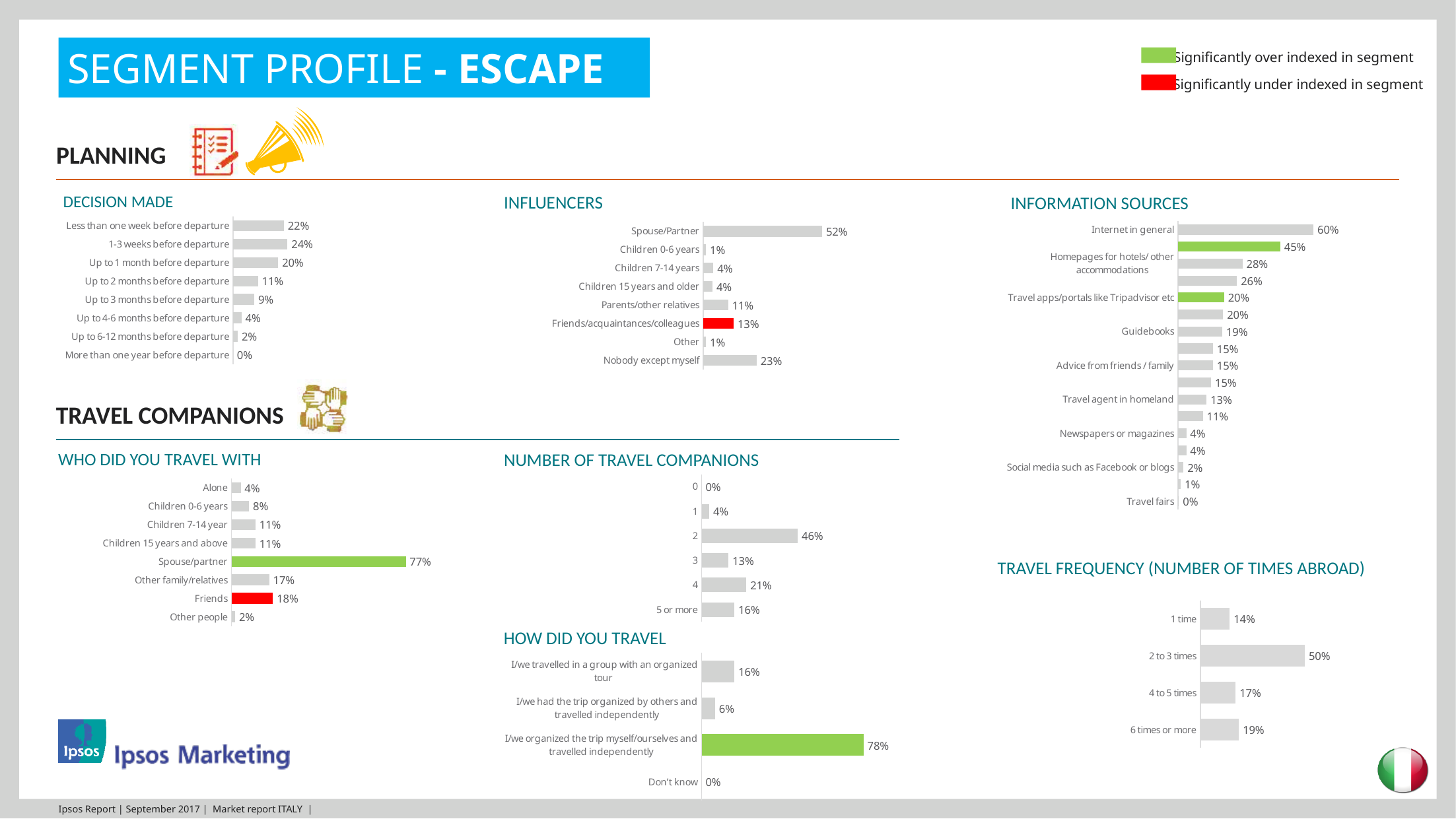
In the HOW DID YOU TRAVEL chart, what is the value for 'I/we organized the trip myself/ourselves and travelled independently'? 78% What type of chart is the TRAVEL FREQUENCY (NUMBER OF TIMES ABROAD) chart? Bar chart In the INFORMATION SOURCES chart, what is the value for Internet in general? 60% In the INFLUENCERS chart, what is the value for Nobody except myself? 23% In the TRAVEL FREQUENCY (NUMBER OF TIMES ABROAD) chart, what is the difference between 2 to 3 times and 1 time? 36% In the WHO DID YOU TRAVEL WITH chart, what is the value for Spouse/partner? 77% In the WHO DID YOU TRAVEL WITH chart, how many categories are shown? 8 In the INFLUENCERS chart, what is the difference between Spouse/Partner and Friends/acquaintances/colleagues? 39% In the INFORMATION SOURCES chart, which is larger, Guidebooks or Travel agent in homeland? Guidebooks In the NUMBER OF TRAVEL COMPANIONS chart, which category has the highest value? 2 In the DECISION MADE chart, which category has the highest value? 1-3 weeks before departure In the DECISION MADE chart, what is the value for 1-3 weeks before departure? 24%